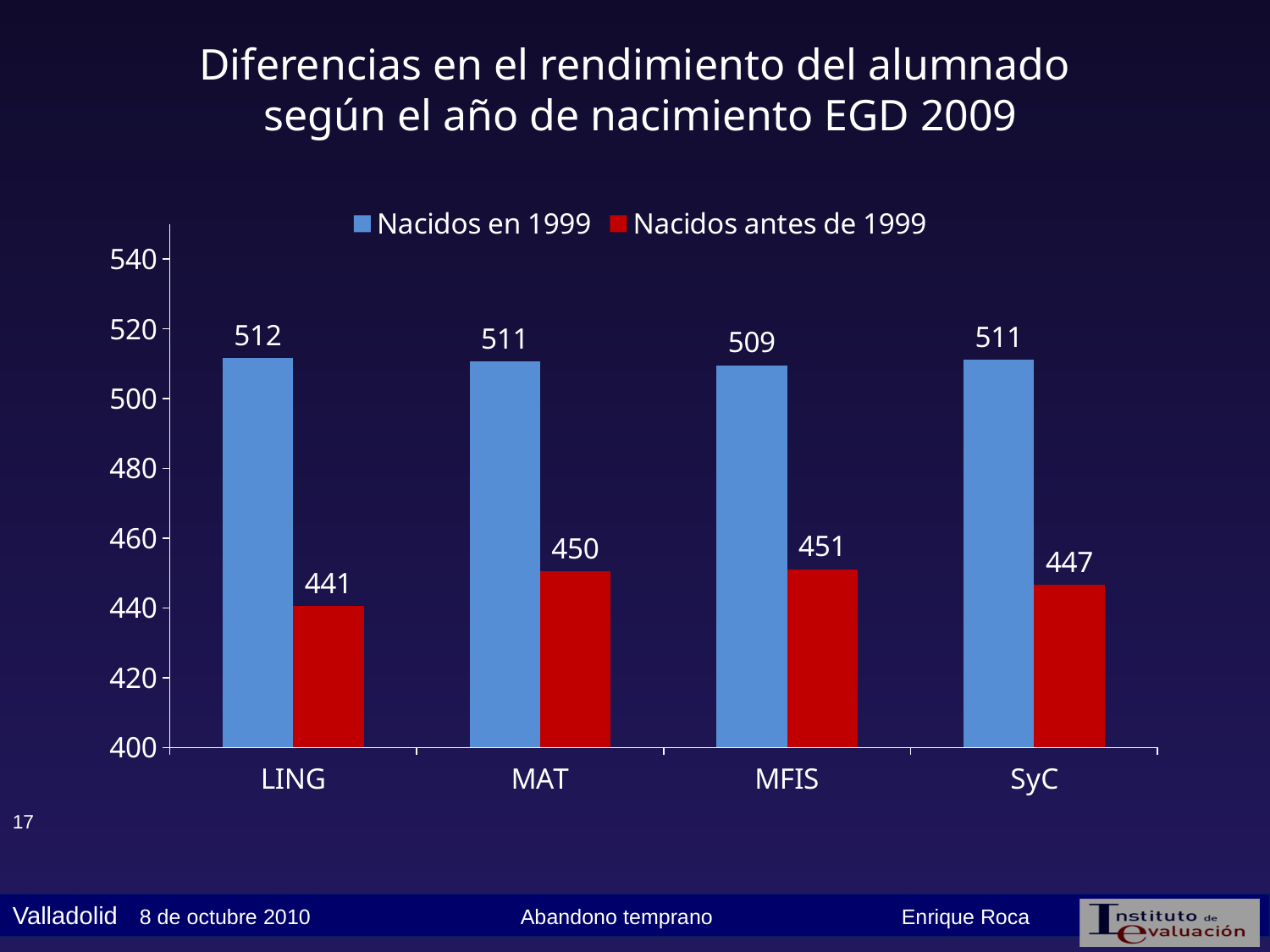
Which is larger in MAT: Nacidos en 1999 or Nacidos antes de 1999? Nacidos en 1999 What is the value for Nacidos antes de 1999 in SyC? 447 What kind of chart is shown on the slide? bar chart What is the value for Nacidos en 1999 in LING? 512 What is the value for Nacidos antes de 1999 in MAT? 450 How many categories are shown on the x axis? 4 What is the difference between Nacidos en 1999 and Nacidos antes de 1999 in MFIS? 58 How many series does the legend list? 2 What colour are the bars for Nacidos antes de 1999? red Which category has the lowest value for Nacidos antes de 1999? LING Which category has the highest value for Nacidos antes de 1999? MFIS What is the difference between Nacidos en 1999 and Nacidos antes de 1999 in LING? 71